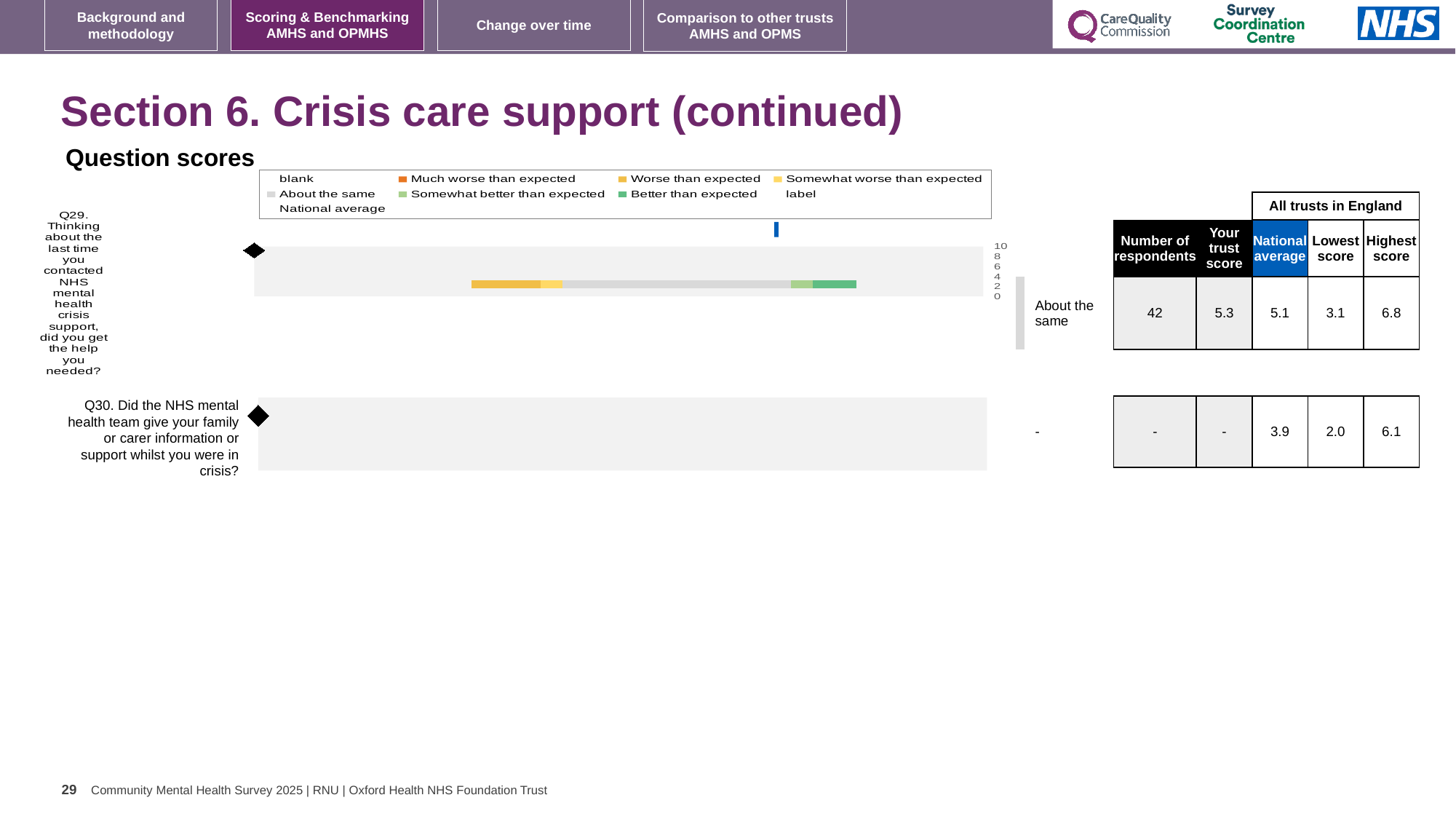
What is the highest score among all trusts in England for Q29? 6.8 What is the trust's score for Q29 in the table beside the chart? 5.3 What is the national average for Q29 in the table beside the chart? 5.1 What is the national average for Q30 in the table beside the chart? 3.9 How many questions are plotted in the question scores chart? 2 What kind of chart is used to show the question scores on this slide? bar chart What is the difference between the highest score and the lowest score for Q29? 3.7 How many entries does the legend of the question scores chart list? 9 What colour represents 'Better than expected' in the legend of the question scores chart? green Which benchmark category is shown for Q29 in the question scores chart? About the same What is the number of respondents for Q29 in the table beside the chart? 42 For Q29, which is larger: the trust's score or the national average? the trust's score